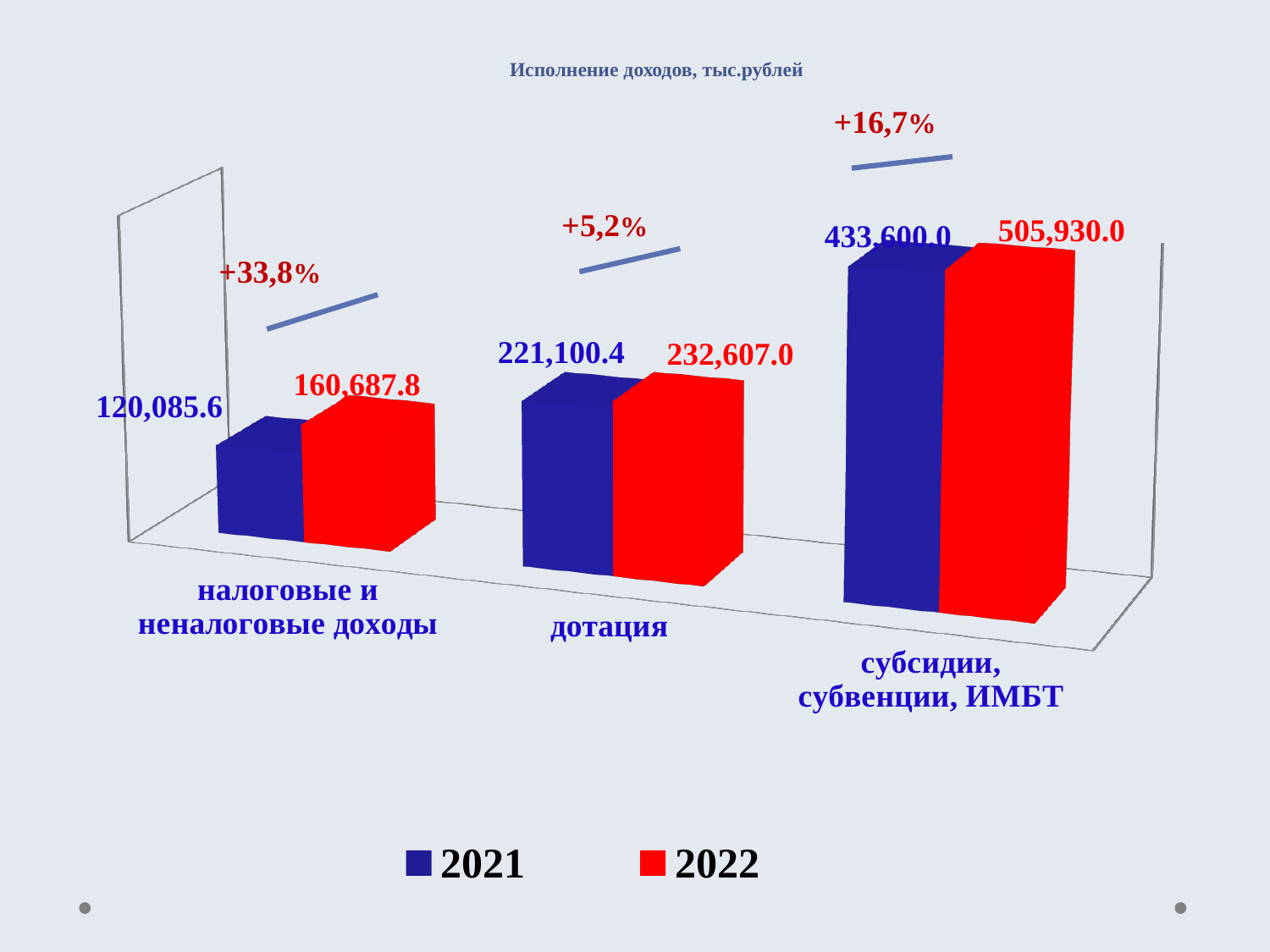
What is the difference between the 2022 and 2021 values for субсидии, субвенции, ИМБТ? 72,330.0 What is the 2021 value for налоговые и неналоговые доходы? 120,085.6 What is the 2022 value for субсидии, субвенции, ИМБТ? 505,930.0 What is the 2022 value for дотация? 232,607.0 What is the difference between the 2022 and 2021 values for налоговые и неналоговые доходы? 40,602.2 Which category has the highest 2022 value? субсидии, субвенции, ИМБТ How many series does the legend list? 2 Which category has the lowest 2021 value? налоговые и неналоговые доходы What is the 2021 value for субсидии, субвенции, ИМБТ? 433,600.0 Which is larger for дотация: the 2021 value or the 2022 value? 2022 What percentage change is annotated above the дотация bars? +5,2% How many categories are shown on the x axis? 3